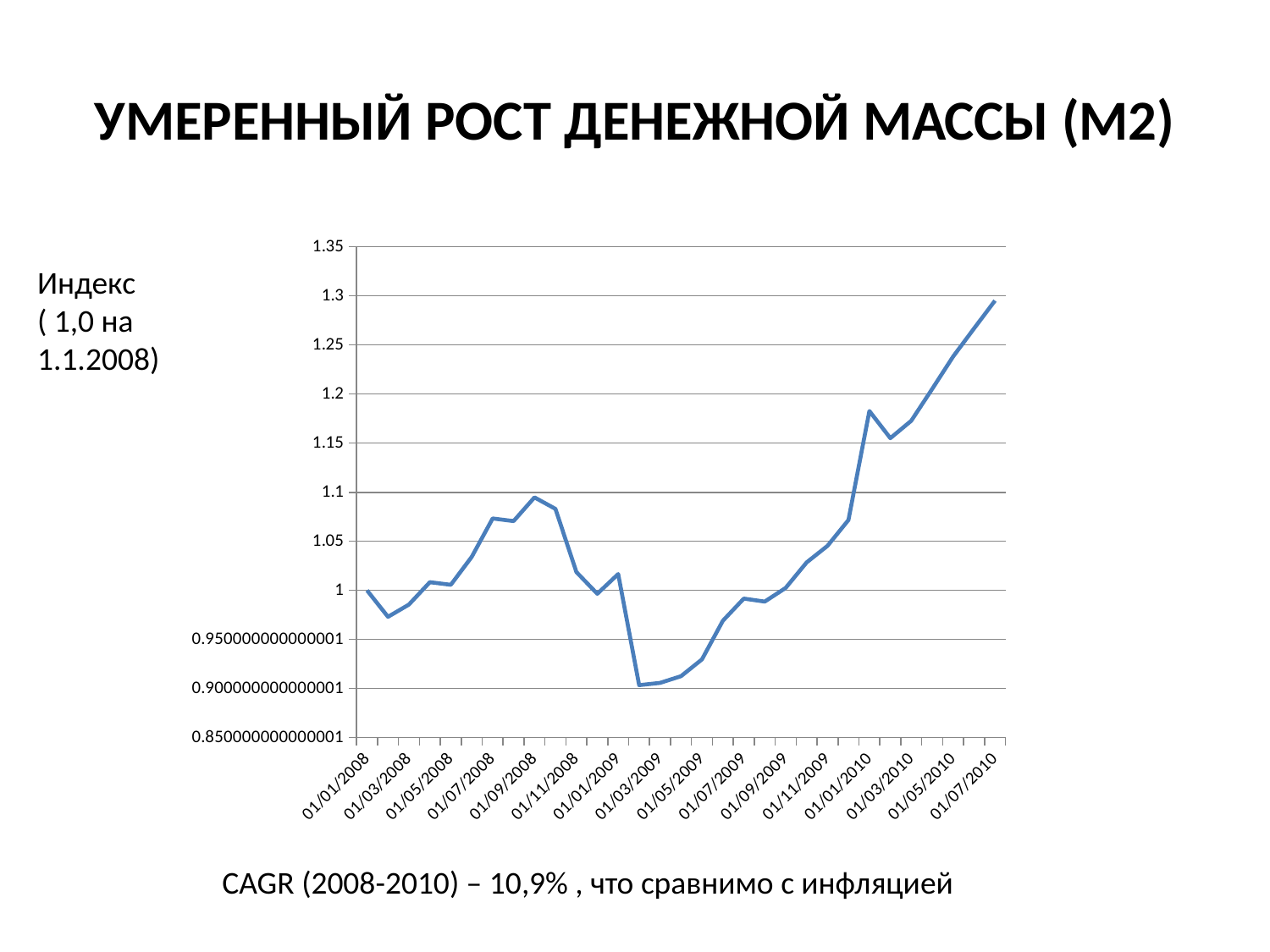
Overall, does the index rise or fall from 01/01/2008 to 01/07/2010? rise What CAGR for 2008-2010 is stated below the chart? 10,9% Which is larger, the index value at 01/09/2008 or at 01/03/2009? 01/09/2008 What kind of chart is shown on the slide? line chart Is the index value at 01/01/2010 greater or less than 1.15? greater Is the index value at 01/07/2010 greater or less than 1.25? greater What is the index value at 01/01/2008? 1 What is the title of the slide's chart? УМЕРЕННЫЙ РОСТ ДЕНЕЖНОЙ МАССЫ (М2) At which date does the index reach its highest value? 01/07/2010 Is the index value at 01/03/2009 greater or less than 0.95? less